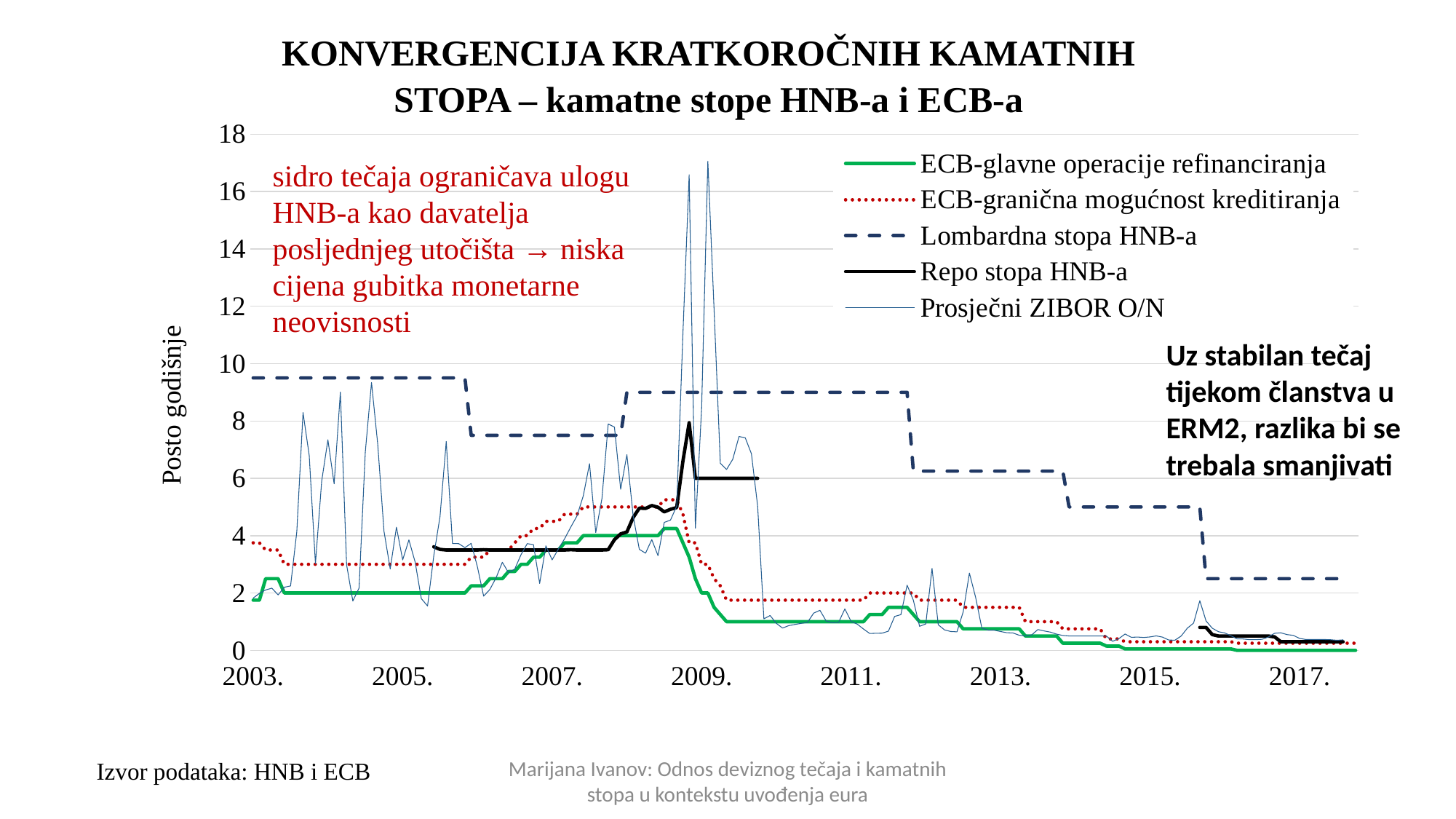
How many series does the legend list? 5 Is the highest value of Prosječni ZIBOR O/N around 2009 greater or less than 14? greater Does the Lombardna stopa HNB-a rise or fall overall from 2003 to 2017? fall In 2011, which is larger: Lombardna stopa HNB-a or ECB-granična mogućnost kreditiranja? Lombardna stopa HNB-a Is the value of Lombardna stopa HNB-a in 2017 greater or less than 4? less What kind of chart is shown on the slide? line chart Is the peak value of Repo stopa HNB-a around 2009 greater or less than 6? greater Which series has the highest value at the start of 2003? Lombardna stopa HNB-a What is the label of the vertical axis? Posto godišnje Which series is drawn as a dashed line in the legend? Lombardna stopa HNB-a